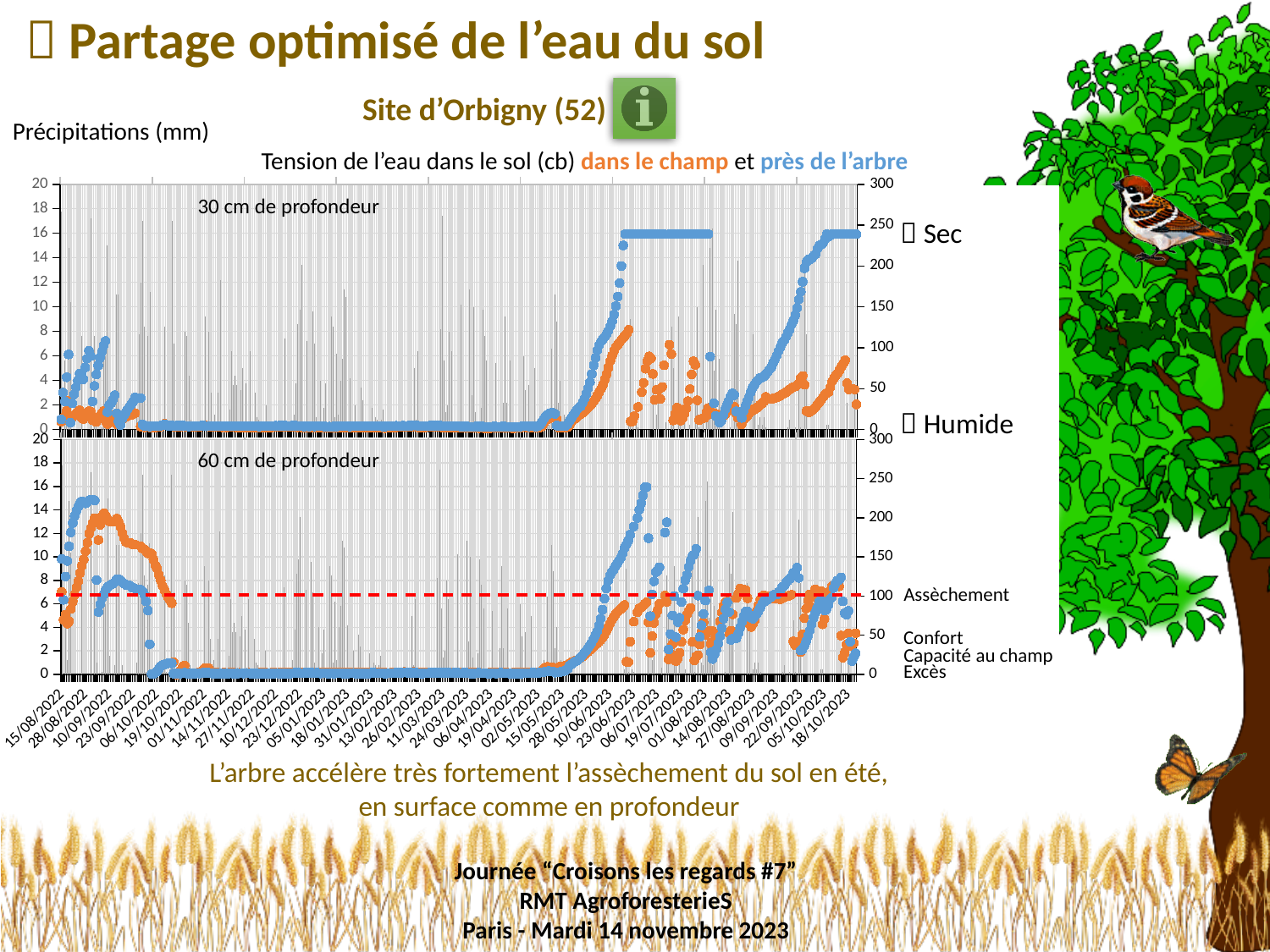
In the top chart (30 cm de profondeur), is the highest value reached by the orange series (dans le champ) greater or less than 150? less In the top chart (30 cm de profondeur), is the highest value reached by the blue series (près de l'arbre) greater or less than 200? greater In the bottom chart (60 cm de profondeur), is the highest value reached by the blue series (près de l'arbre) greater or less than 200? greater Which colour represents the soil water tension measured 'dans le champ'? orange At which site were the measurements shown in the charts taken? Site d'Orbigny (52) In the top chart (30 cm de profondeur), around 06/07/2023, which series is higher: the blue one (près de l'arbre) or the orange one (dans le champ)? blue (près de l'arbre) How many charts are shown on the slide? 2 In the top chart (30 cm de profondeur), what kind of chart is used to plot the precipitation series? bar chart In the top chart (30 cm de profondeur), does the blue series (près de l'arbre) rise or fall between 15/05/2023 and 23/06/2023? rise What is the maximum value shown on the right-hand axis (tension de l'eau dans le sol, cb) of the charts? 300 What is the maximum value shown on the left-hand axis (précipitations, mm) of the charts? 20 In the bottom chart (60 cm de profondeur), at what value on the right axis is the red dashed 'Assèchement' line drawn? 100